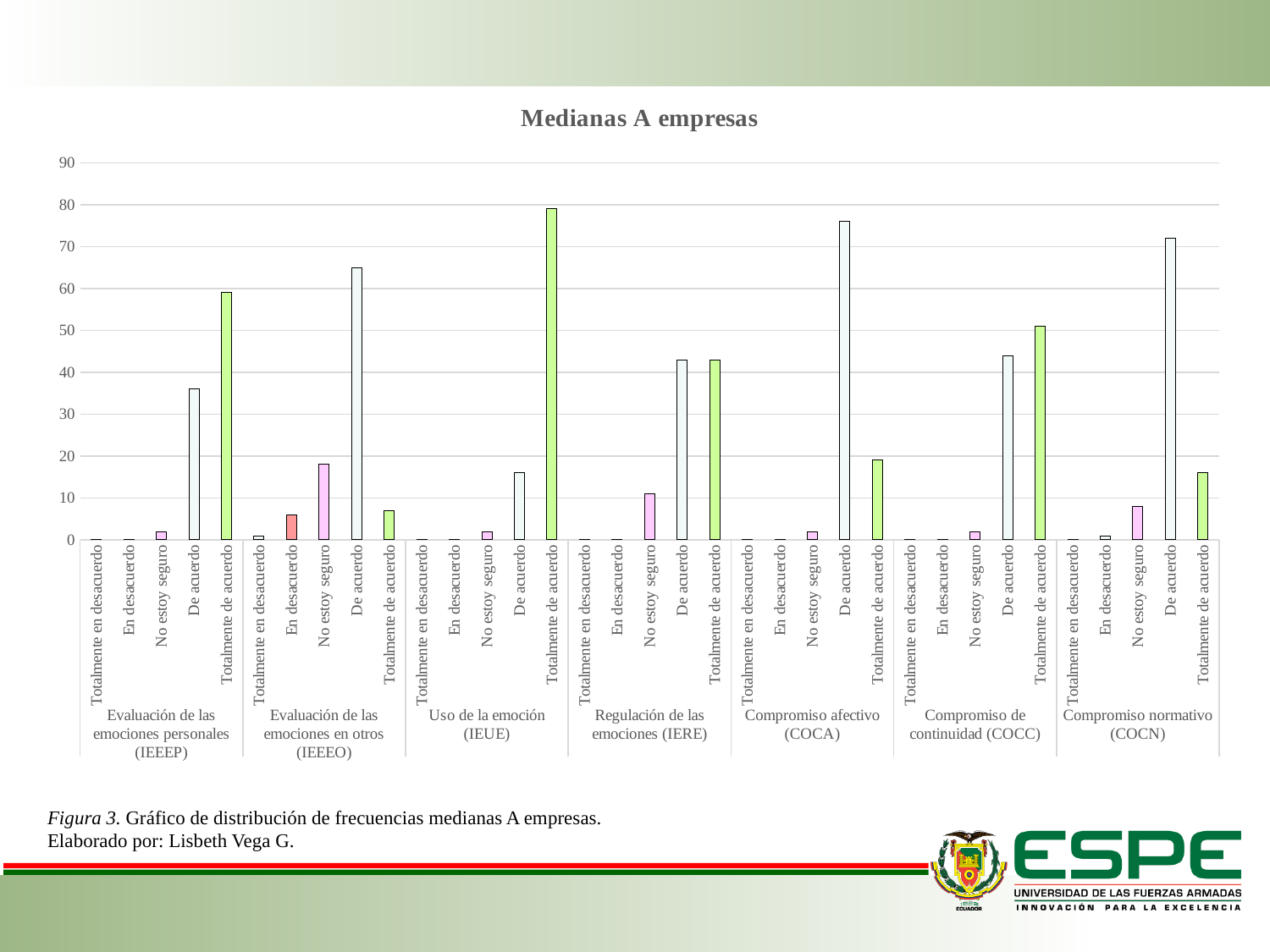
In the 'Compromiso afectivo (COCA)' group, which is larger: 'De acuerdo' or 'Totalmente de acuerdo'? De acuerdo How many response categories are shown within each dimension group? 5 Within the 'Compromiso afectivo (COCA)' group, which response category has the highest bar? De acuerdo Is the value for 'No estoy seguro' in the 'Regulación de las emociones (IERE)' group greater or less than 20? less Within the 'Evaluación de las emociones personales (IEEEP)' group, which response category has the highest bar? Totalmente de acuerdo Is the value for 'Totalmente de acuerdo' in the 'Uso de la emoción (IEUE)' group greater or less than 70? greater How many dimension groups (such as IEEEP, IEEEO, IEUE) are shown along the x axis? 7 What is the title of the chart? Medianas A empresas What kind of chart is shown on the slide? bar chart Within the 'Evaluación de las emociones en otros (IEEEO)' group, which response category has the highest bar? De acuerdo Is the value for 'De acuerdo' in the IEEEP group greater or less than 30? greater